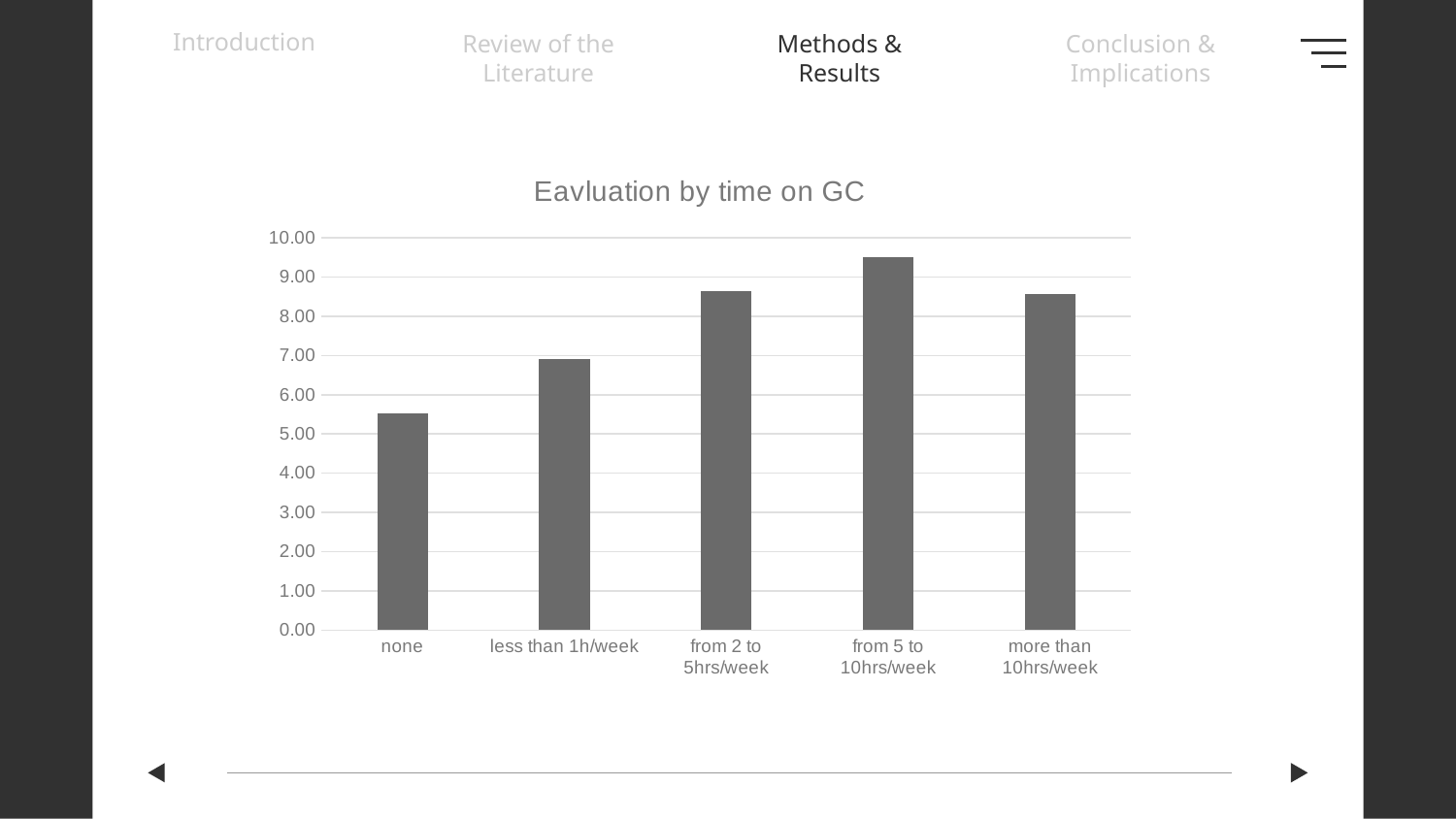
Is the value for 'from 5 to 10hrs/week' greater or less than 9.00? greater Is the value for 'more than 10hrs/week' greater or less than 9.00? less Which is larger, the value for 'from 5 to 10hrs/week' or the value for 'more than 10hrs/week'? from 5 to 10hrs/week Is the value for 'from 2 to 5hrs/week' greater or less than 8.00? greater Which category has the highest value in the chart? from 5 to 10hrs/week Which is larger, the value for 'none' or the value for 'less than 1h/week'? less than 1h/week What type of chart is shown on the slide? bar chart What is the title of the chart? Eavluation by time on GC How many categories are shown on the x axis of the chart? 5 Which category has the lowest value in the chart? none